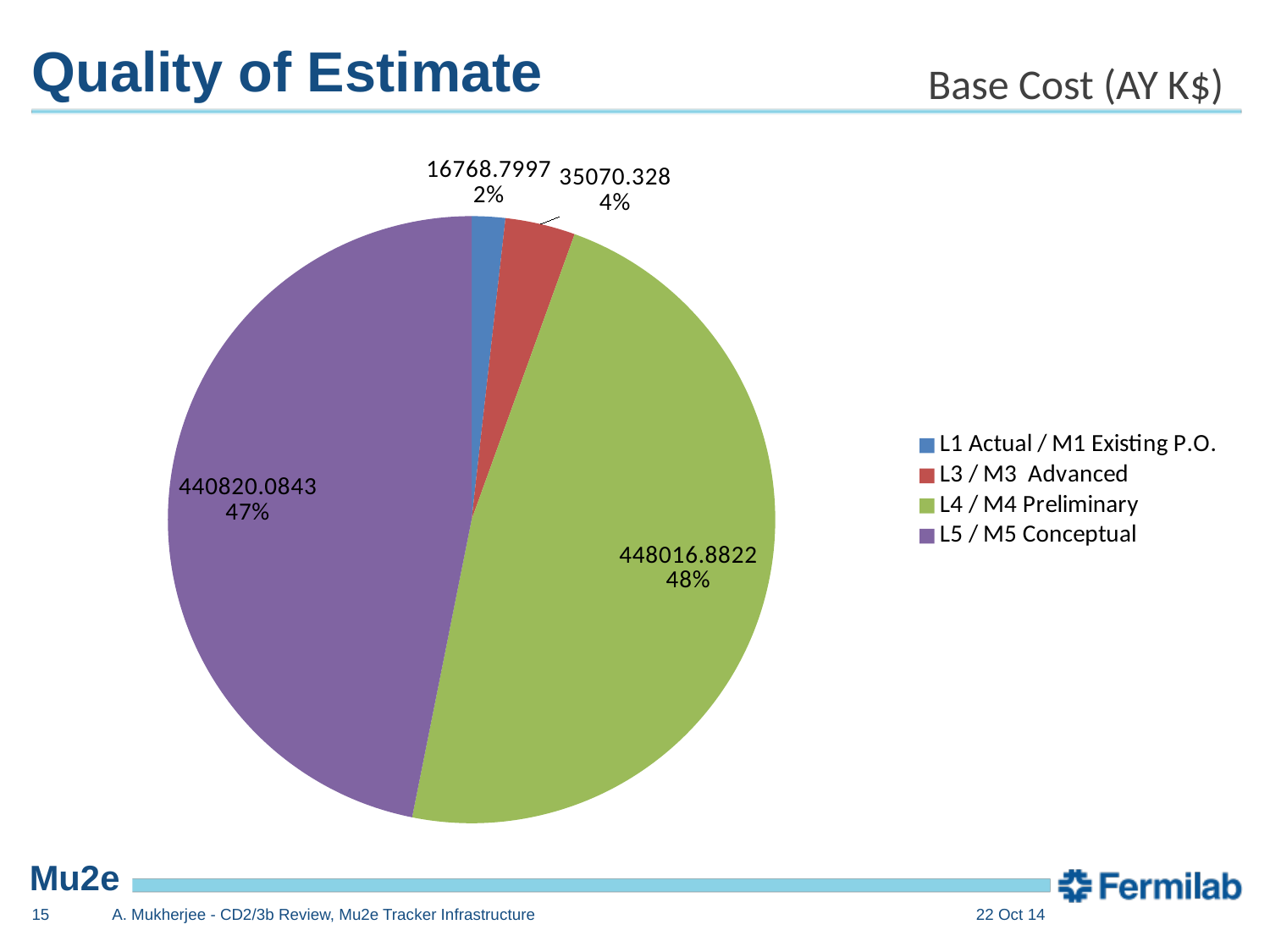
Which category has the smallest slice of the pie? L1 Actual / M1 Existing P.O. What is the difference between the values for L4 / M4 Preliminary and L5 / M5 Conceptual? 7196.7979 What is the value for L5 / M5 Conceptual? 440820.0843 What type of chart is shown on the slide? pie chart What share of the pie does L4 / M4 Preliminary represent? 48% How many categories does the pie chart have? 4 What is the value for L3 / M3 Advanced? 35070.328 Which category has the largest slice of the pie? L4 / M4 Preliminary What share of the pie does L1 Actual / M1 Existing P.O. represent? 2% What is the value for L4 / M4 Preliminary? 448016.8822 What is the value for L1 Actual / M1 Existing P.O.? 16768.7997 Which colour represents L5 / M5 Conceptual in the legend? purple